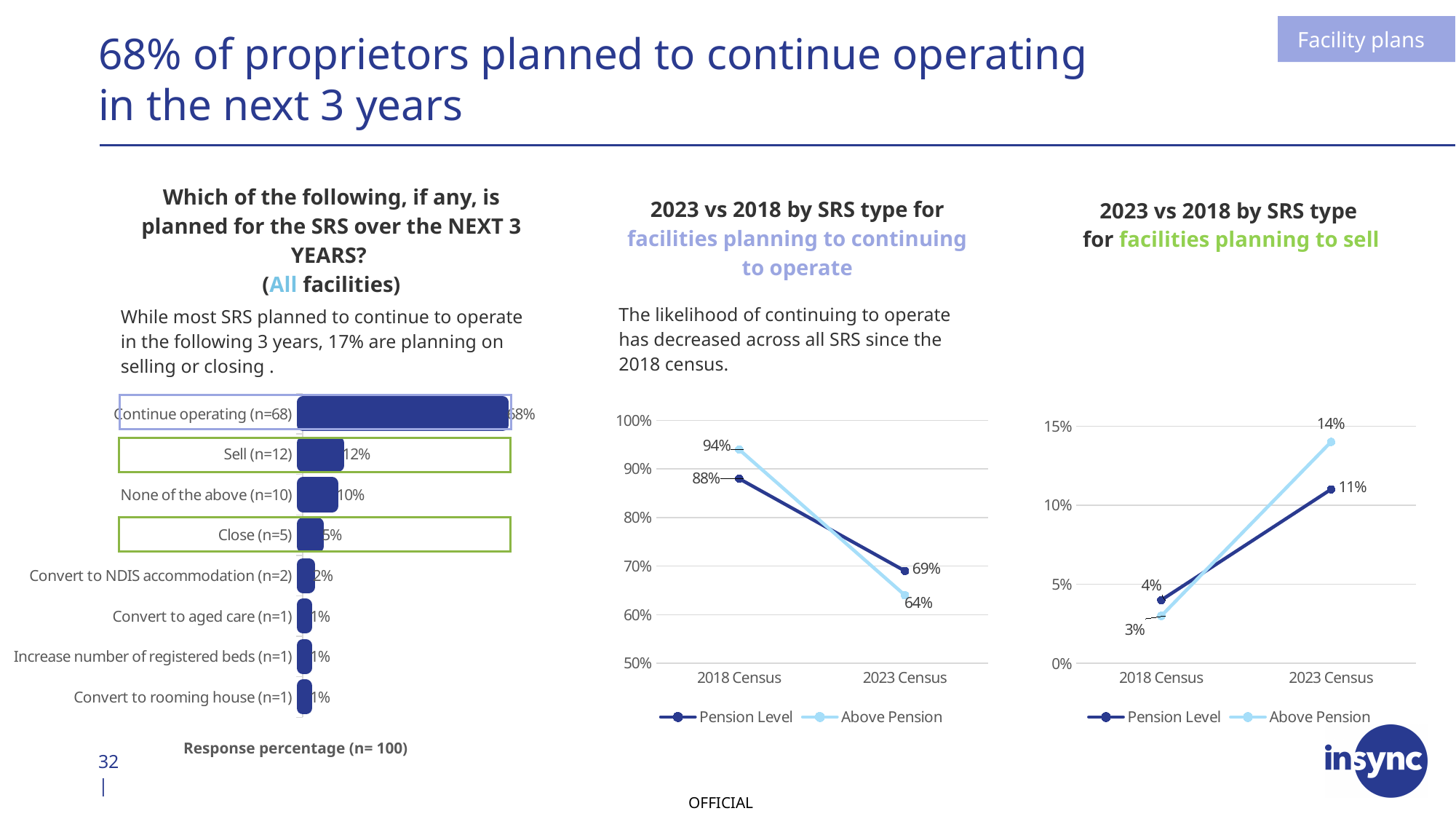
In the middle chart (facilities planning to continue to operate), what is the Above Pension value for the 2018 Census? 94% In the left bar chart (planned for the SRS over the next 3 years), what is the value for Sell (n=12)? 12% In the left bar chart (planned for the SRS over the next 3 years), which category has the highest value? Continue operating (n=68) In the left bar chart (planned for the SRS over the next 3 years), how many categories are shown? 8 In the left bar chart (planned for the SRS over the next 3 years), what is the difference between Continue operating and Sell? 56% In the middle chart (facilities planning to continue to operate), does the Above Pension series rise or fall from the 2018 Census to the 2023 Census? Fall In the middle chart (facilities planning to continue to operate), what is the Pension Level value for the 2023 Census? 69% In the right chart (facilities planning to sell), what is the Above Pension value for the 2023 Census? 14% What kind of chart is the left chart about plans for the SRS over the next 3 years? Bar chart In the right chart (facilities planning to sell), what is the difference between the Pension Level values for the 2023 Census and the 2018 Census? 7% In the middle chart (facilities planning to continue to operate), how many series does the legend list? 2 In the right chart (facilities planning to sell), which series is higher at the 2023 Census, Pension Level or Above Pension? Above Pension